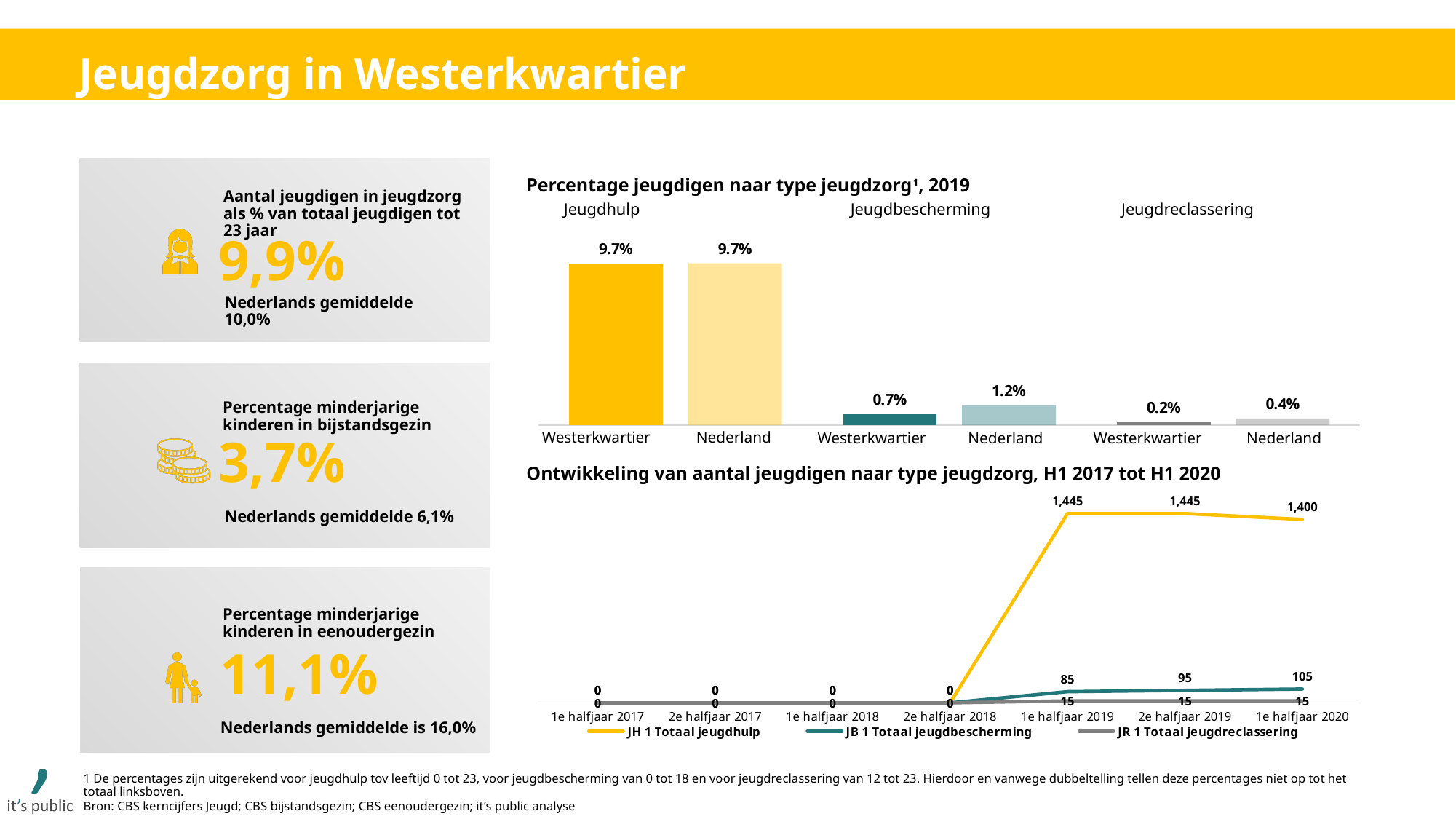
In the chart 'Ontwikkeling van aantal jeugdigen naar type jeugdzorg, H1 2017 tot H1 2020', how many time points are shown on the x axis? 7 In the chart 'Ontwikkeling van aantal jeugdigen naar type jeugdzorg, H1 2017 tot H1 2020', what is the value of JH 1 Totaal jeugdhulp in 1e halfjaar 2020? 1,400 In the chart 'Percentage jeugdigen naar type jeugdzorg, 2019', which is larger under Jeugdreclassering: Westerkwartier or Nederland? Nederland In the chart 'Ontwikkeling van aantal jeugdigen naar type jeugdzorg, H1 2017 tot H1 2020', does JB 1 Totaal jeugdbescherming rise or fall from 1e halfjaar 2019 to 1e halfjaar 2020? Rise In the chart 'Percentage jeugdigen naar type jeugdzorg, 2019', what is the value for Westerkwartier under Jeugdhulp? 9.7% In the chart 'Percentage jeugdigen naar type jeugdzorg, 2019', how many bars are plotted? 6 In the chart 'Percentage jeugdigen naar type jeugdzorg, 2019', what is the value for Nederland under Jeugdreclassering? 0.4% In the chart 'Ontwikkeling van aantal jeugdigen naar type jeugdzorg, H1 2017 tot H1 2020', how many series does the legend list? 3 In the chart 'Percentage jeugdigen naar type jeugdzorg, 2019', what is the difference between Nederland and Westerkwartier under Jeugdbescherming? 0.5% In the chart 'Percentage jeugdigen naar type jeugdzorg, 2019', what is the value for Westerkwartier under Jeugdbescherming? 0.7% What kind of chart is 'Percentage jeugdigen naar type jeugdzorg, 2019'? Bar chart In the chart 'Ontwikkeling van aantal jeugdigen naar type jeugdzorg, H1 2017 tot H1 2020', what is the value of JB 1 Totaal jeugdbescherming in 2e halfjaar 2019? 95